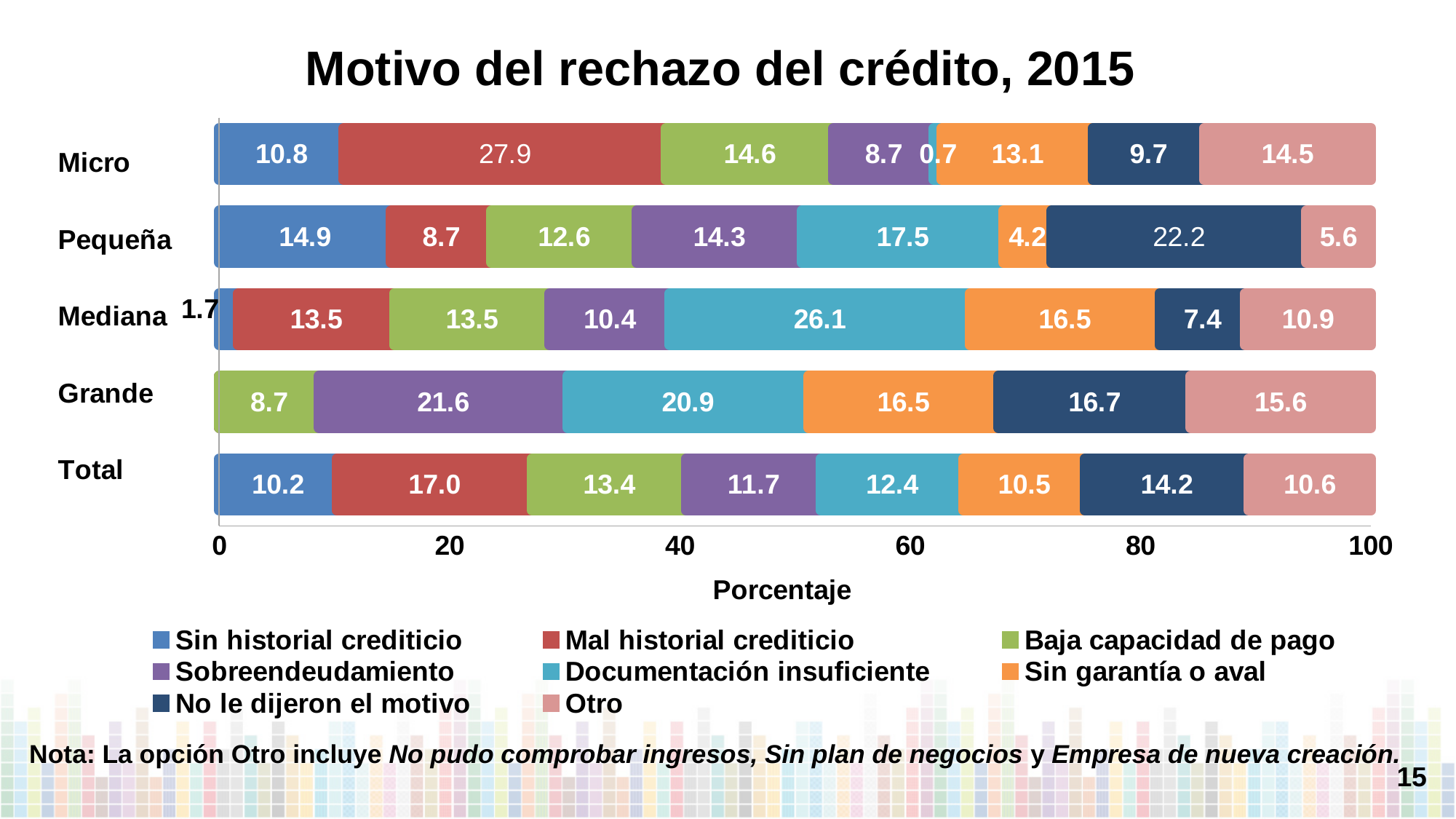
Which category has the lowest value for Otro? Pequeña What kind of chart is shown on the slide? Stacked bar chart What is the value of No le dijeron el motivo for Pequeña? 22.2 Which category has the highest value for Documentación insuficiente? Mediana What is the difference between the Mal historial crediticio values for Micro and Pequeña? 19.2 What is the value of Sin historial crediticio for Mediana? 1.7 Which has a larger Sin garantía o aval value, Micro or Pequeña? Micro How many categories are shown on the y axis? 5 What is the value of Mal historial crediticio for Micro? 27.9 What is the value of Documentación insuficiente for Mediana? 26.1 How many series does the legend list? 8 What is the value of Sobreendeudamiento for Grande? 21.6